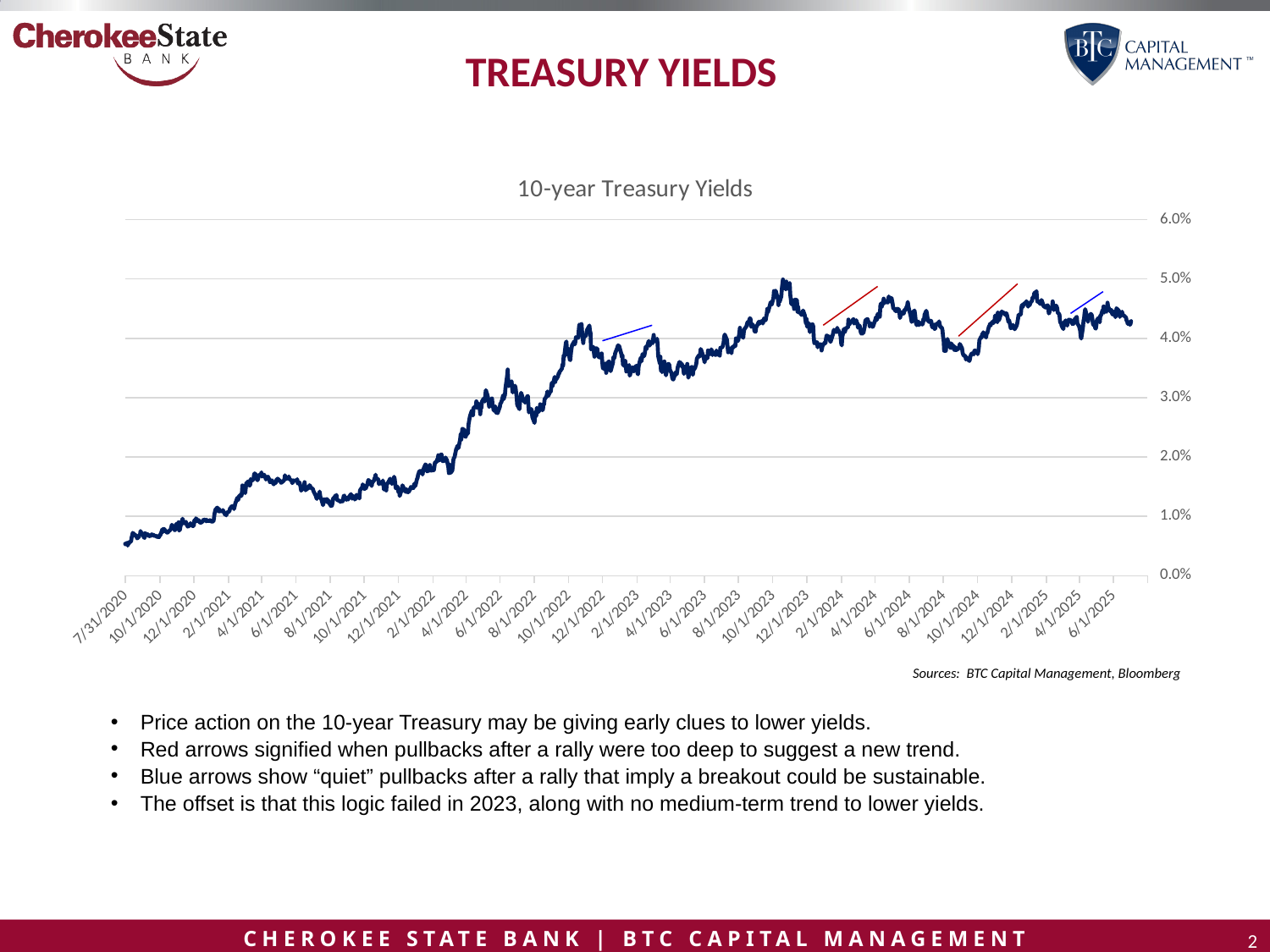
Is the 10-year Treasury yield at 4/1/2023 greater or less than 4.0%? less Is the 10-year Treasury yield at 8/1/2021 greater or less than 2.0%? less Which is larger, the 10-year Treasury yield at 7/31/2020 or at 10/1/2023? 10/1/2023 Is the 10-year Treasury yield at 10/1/2023 greater or less than 4.0%? greater What kind of chart is shown on the slide? Line chart What is the highest value shown on the chart's vertical axis? 6.0% Which is larger, the 10-year Treasury yield at 4/1/2021 or at 4/1/2023? 4/1/2023 Overall, do the 10-year Treasury yields rise or fall from 7/31/2020 to 6/1/2025? Rise What is the title of the chart? 10-year Treasury Yields